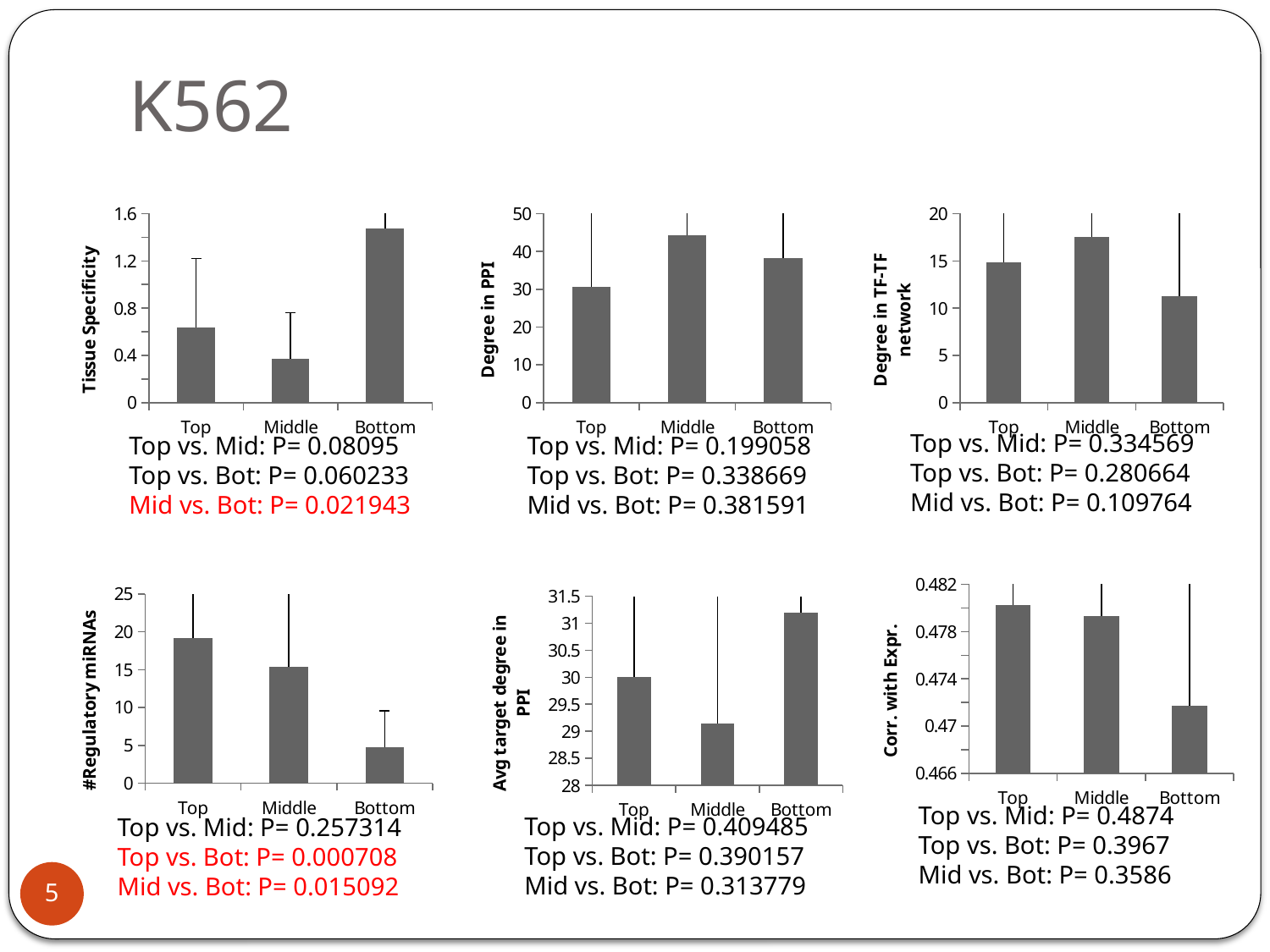
What kind of chart is the Tissue Specificity chart (top left)? bar chart In the Avg target degree in PPI chart (bottom middle), which is larger, Top or Middle? Top In the Corr. with Expr. chart (bottom right), which category has the lowest value? Bottom In the Degree in TF-TF network chart (top right), which category has the lowest value? Bottom In the Tissue Specificity chart (top left), which category has the highest value? Bottom In the Degree in PPI chart (top middle), which category has the highest value? Middle How many categories are shown on the x axis of the Degree in PPI chart (top middle)? 3 In the Tissue Specificity chart (top left), is the value for Bottom greater or less than 1.2? greater In the #Regulatory miRNAs chart (bottom left), do the values rise or fall from Top to Bottom? fall In the Degree in PPI chart (top middle), is the value for Middle greater or less than 40? greater In the #Regulatory miRNAs chart (bottom left), is the value for Bottom greater or less than 10? less In the Tissue Specificity chart (top left), which category has the lowest value? Middle